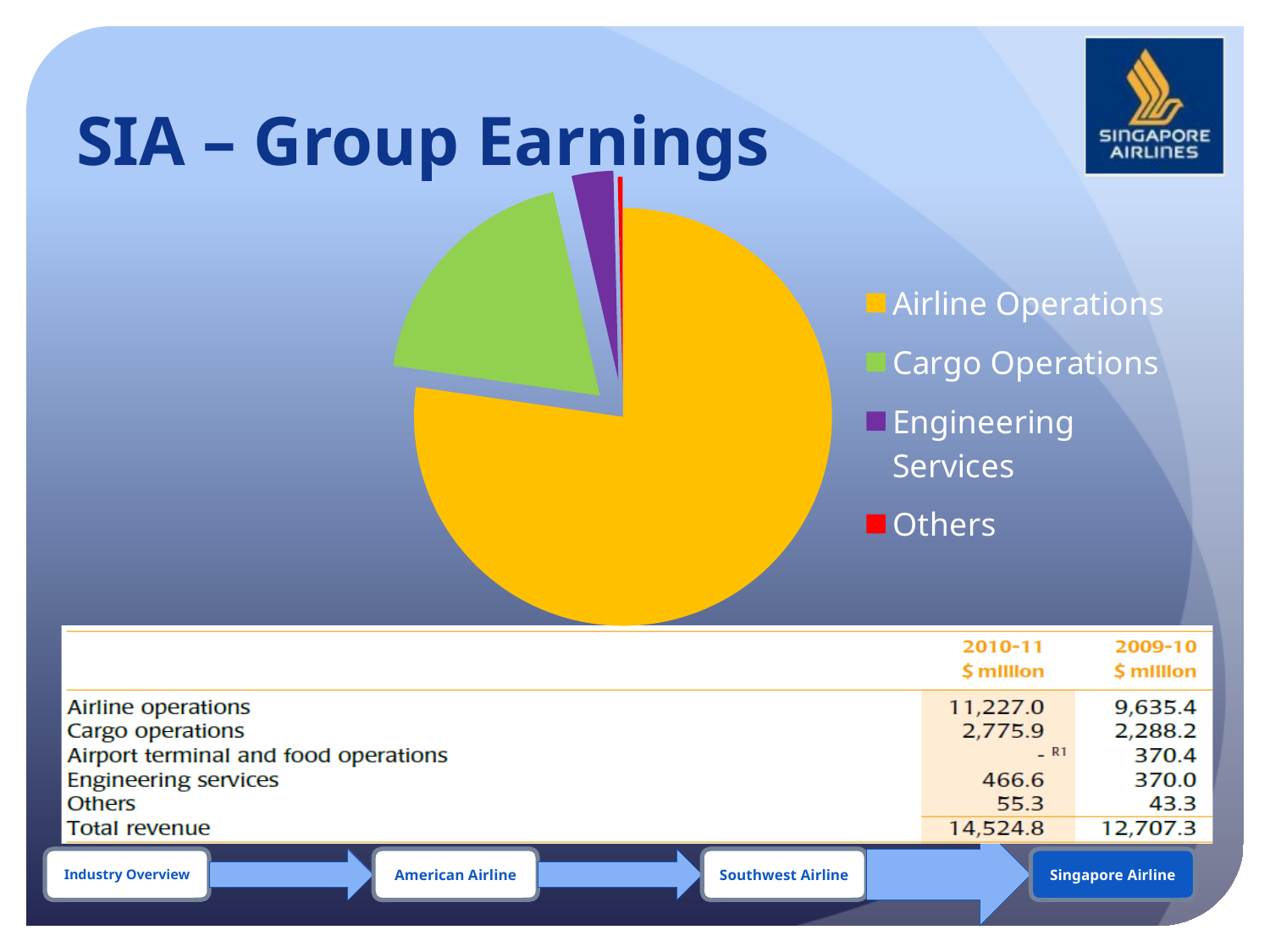
Which slice is larger in the pie chart, Cargo Operations or Engineering Services? Cargo Operations How many entries does the pie chart's legend list? 4 Which category has the smallest slice of the pie chart? Others How many slices does the pie chart have? 4 Which slice is larger in the pie chart, Engineering Services or Others? Engineering Services Which slice is larger in the pie chart, Airline Operations or Cargo Operations? Airline Operations What is the title of the slide containing the pie chart? SIA – Group Earnings What kind of chart is shown on the slide? pie chart Which category has the largest slice of the pie chart? Airline Operations What colour is the Cargo Operations slice in the pie chart? green